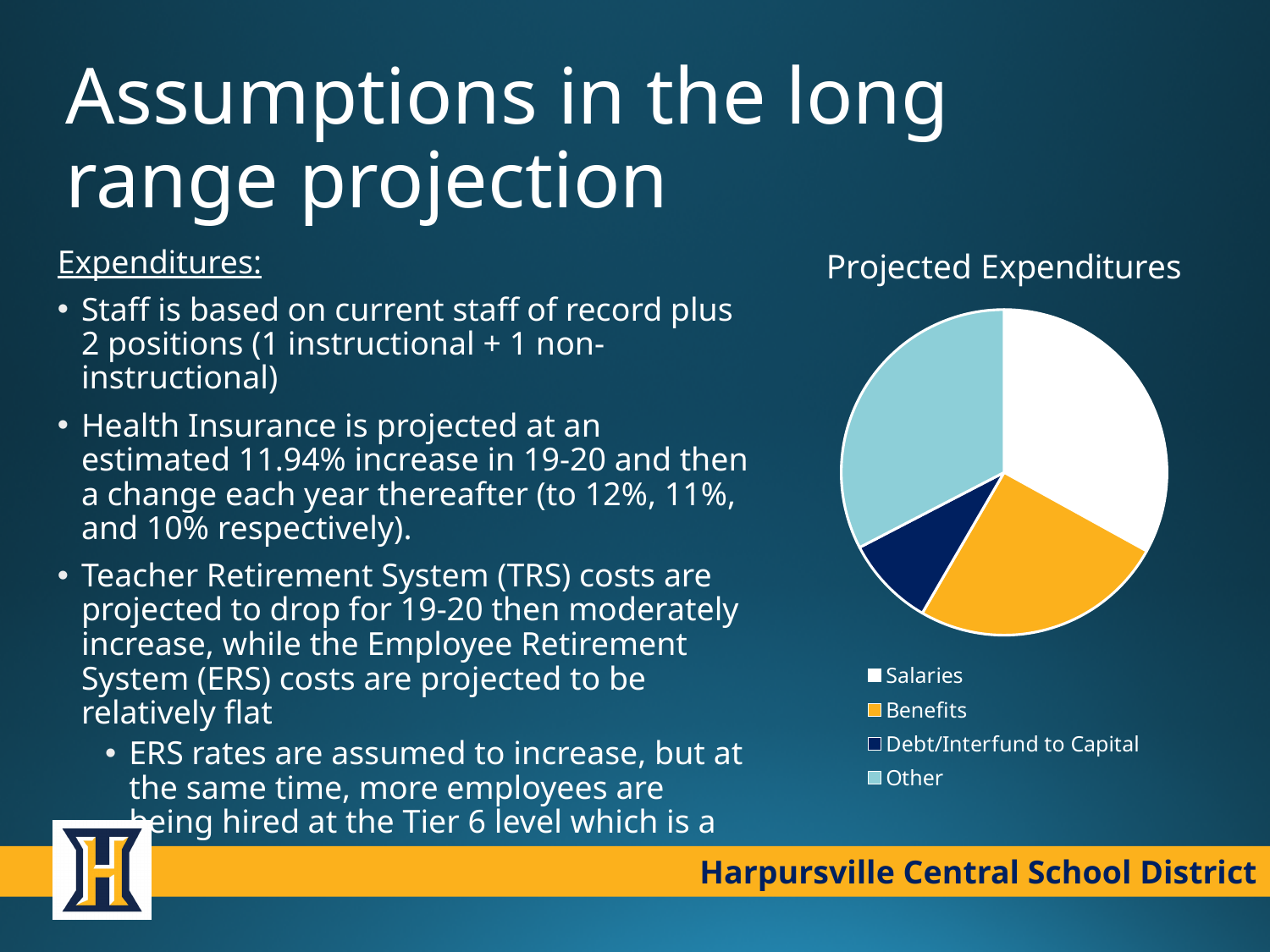
What kind of chart is shown on the slide? Pie chart How many entries does the legend of the Projected Expenditures chart list? 4 In the Projected Expenditures chart, which slice is larger: Benefits or Debt/Interfund to Capital? Benefits What is the title of the chart on the slide? Projected Expenditures In the Projected Expenditures chart, which slice is larger: Salaries or Benefits? Salaries Which category has the largest slice in the Projected Expenditures pie chart? Salaries How many slices does the Projected Expenditures pie chart have? 4 In the Projected Expenditures chart, which slice is larger: Other or Debt/Interfund to Capital? Other Which category has the smallest slice in the Projected Expenditures pie chart? Debt/Interfund to Capital What colour is the Salaries slice in the Projected Expenditures pie chart? White